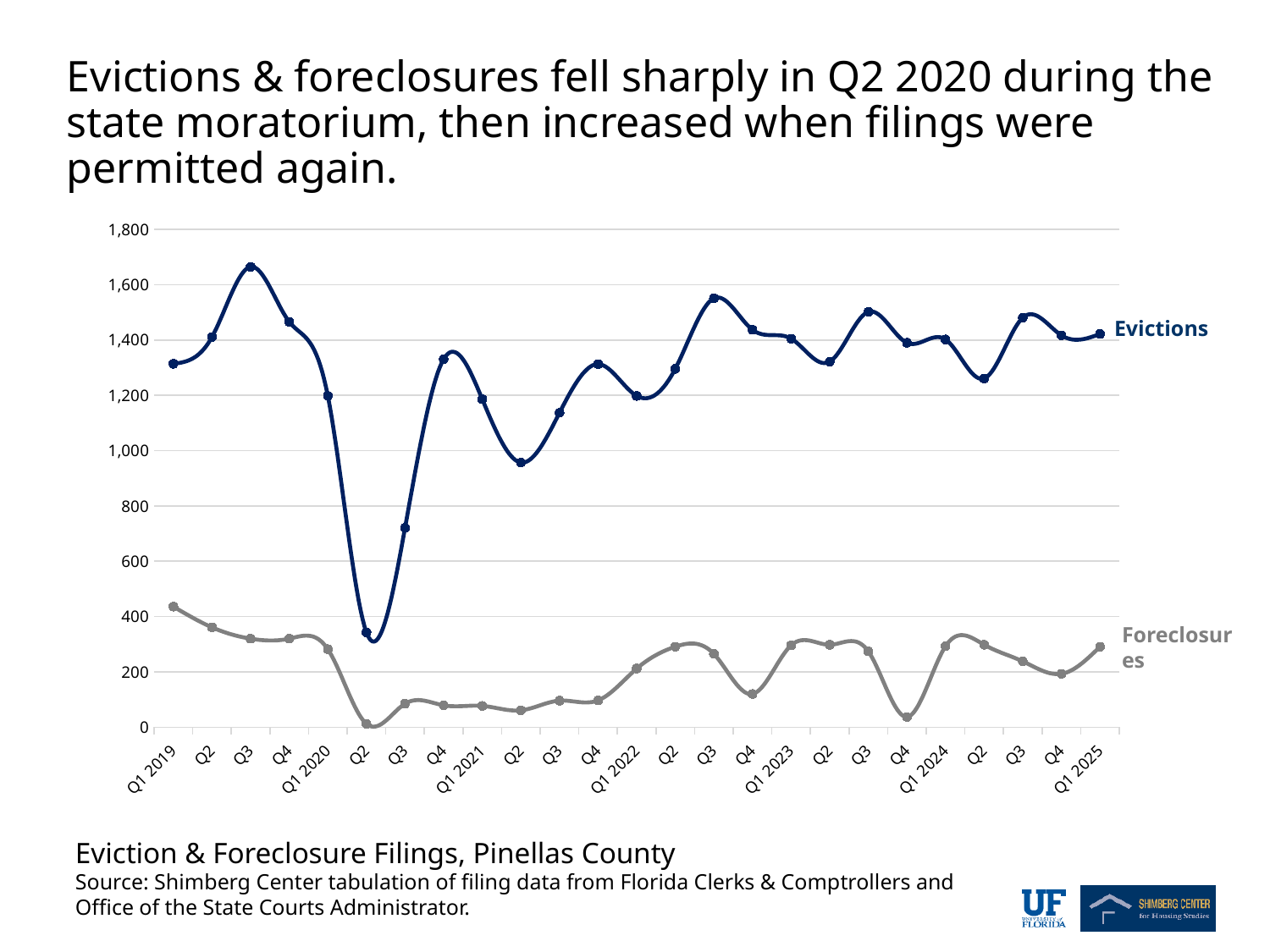
In which quarter did the Evictions series reach its highest value? Q3 2019 Which quarter has the higher Evictions value, Q3 2019 or Q3 2022? Q3 2019 What kind of chart is shown on the slide? line chart How many series are plotted on the chart? 2 In which quarter did the Evictions series reach its lowest value? Q2 2020 What is the title of the chart given below the plot? Eviction & Foreclosure Filings, Pinellas County Is the Evictions value for Q2 2020 greater or less than 400? less Is the Foreclosures value for Q1 2019 greater or less than 400? greater In which quarter did the Foreclosures series reach its highest value? Q1 2019 Is the Evictions value for Q3 2019 greater or less than 1,600? greater How many quarters are plotted along the x axis, from Q1 2019 to Q1 2025? 25 Do Evictions rise or fall from Q2 2020 to Q4 2020? rise